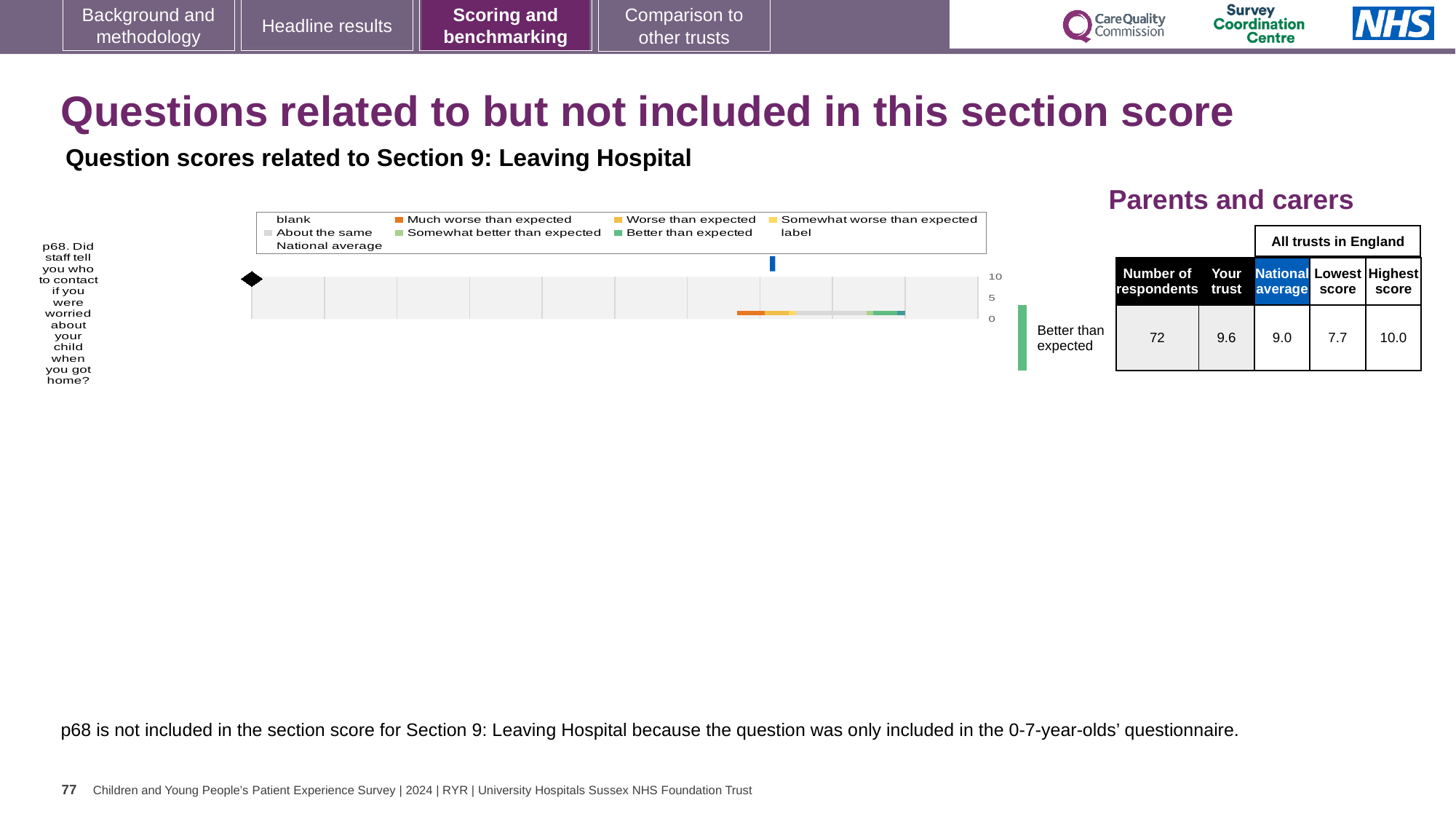
Which is larger for p68: the Your trust score or the National average score? Your trust What kind of chart is shown for question p68? bar chart In the table next to the chart, what is the Highest score among all trusts in England for p68? 10.0 In the table next to the chart, what is the Lowest score among all trusts in England for p68? 7.7 What rating is shown beside the chart for the trust's result on p68? Better than expected What is the difference between the Your trust score and the National average score for p68? 0.6 In the table next to the chart, what is the National average score for p68? 9.0 What colour does the legend use for 'Much worse than expected'? orange What is the difference between the Highest score and the Lowest score for p68? 2.3 How many respondents answered p68 according to the table next to the chart? 72 In the table next to the chart, what is the score for Your trust on p68? 9.6 Which survey question is plotted in the chart? p68. Did staff tell you who to contact if you were worried about your child when you got home?